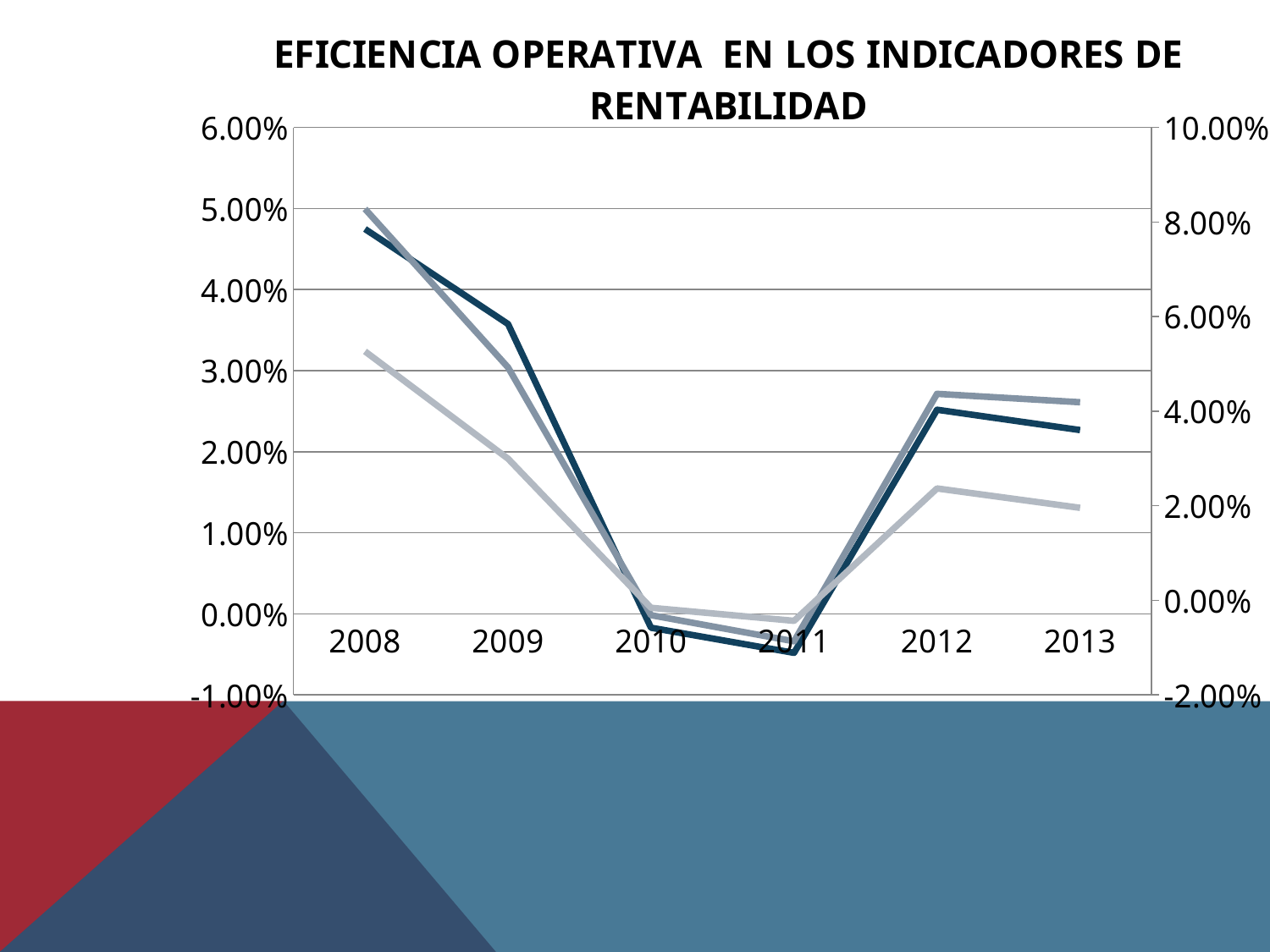
What is the title of the chart? EFICIENCIA OPERATIVA EN LOS INDICADORES DE RENTABILIDAD What is the first year shown on the x axis? 2008 How many lines are plotted on the chart? 3 What is the highest value shown on the left y axis? 6.00% Is the dark blue line higher in 2008 or in 2013? 2008 How many years are shown on the x axis of the chart? 6 In which year does the dark blue line reach its highest point? 2008 Do the lines rise or fall from 2011 to 2012? rise What type of chart is shown on the slide? line chart In which year does the dark blue line reach its lowest point? 2011 What is the last year shown on the x axis? 2013 Do the lines rise or fall from 2008 to 2010? fall